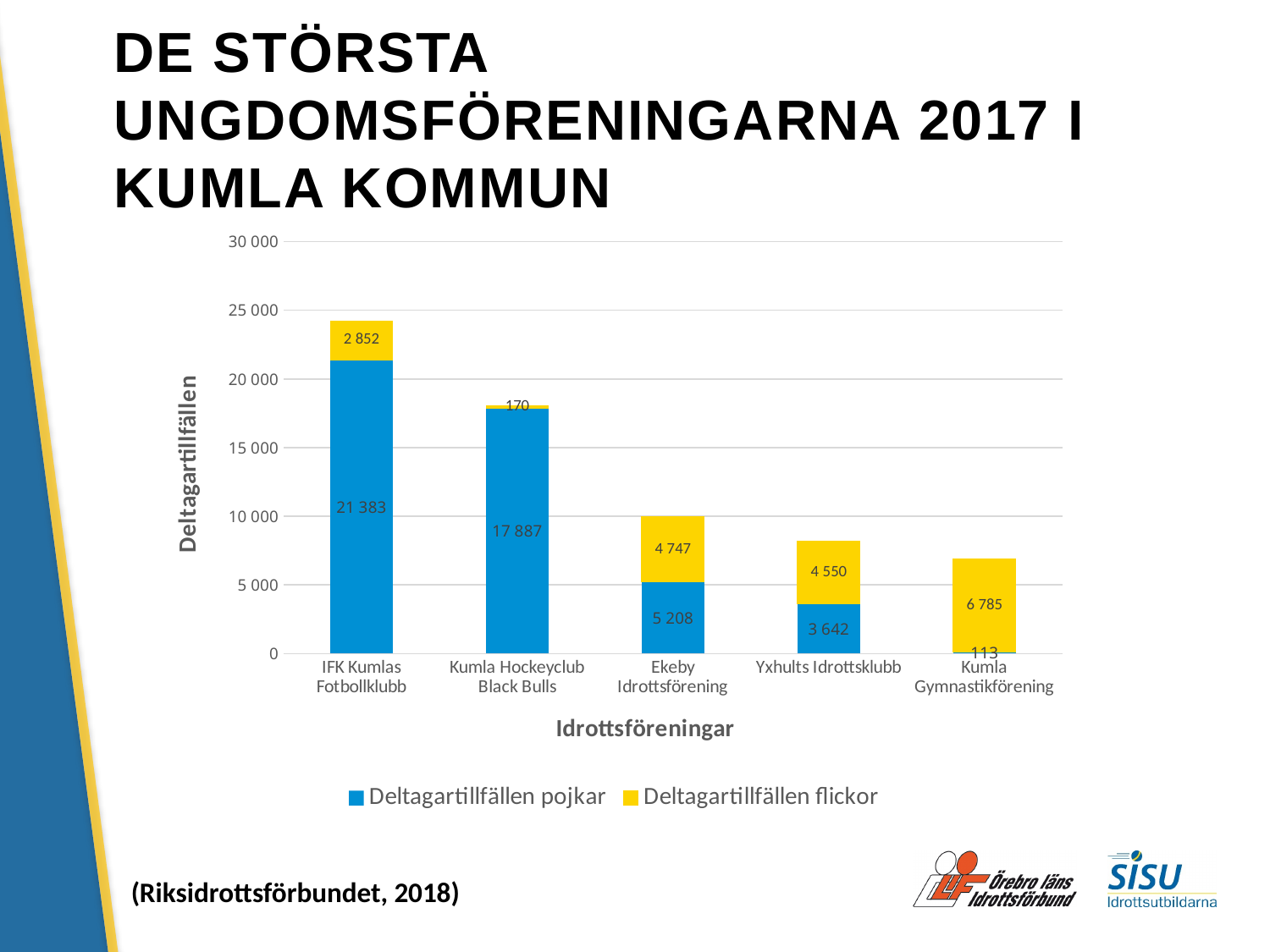
How many associations are shown on the x axis? 5 Which association has the lowest value for Deltagartillfällen pojkar? Kumla Gymnastikförening What is the total of the stacked bar for IFK Kumlas Fotbollklubb? 24 235 What is the value of Deltagartillfällen flickor for Kumla Gymnastikförening? 6 785 Which association has the highest value for Deltagartillfällen flickor? Kumla Gymnastikförening Is the total stacked bar for Kumla Hockeyclub Black Bulls greater or less than 15 000? greater What is the difference between Deltagartillfällen pojkar and Deltagartillfällen flickor for Ekeby Idrottsförening? 461 How many series does the legend list? 2 What is the value of Deltagartillfällen flickor for Kumla Hockeyclub Black Bulls? 170 Which is larger for Yxhults Idrottsklubb: Deltagartillfällen pojkar or Deltagartillfällen flickor? Deltagartillfällen flickor What kind of chart is shown on the slide? Stacked bar chart What is the value of Deltagartillfällen pojkar for IFK Kumlas Fotbollklubb? 21 383